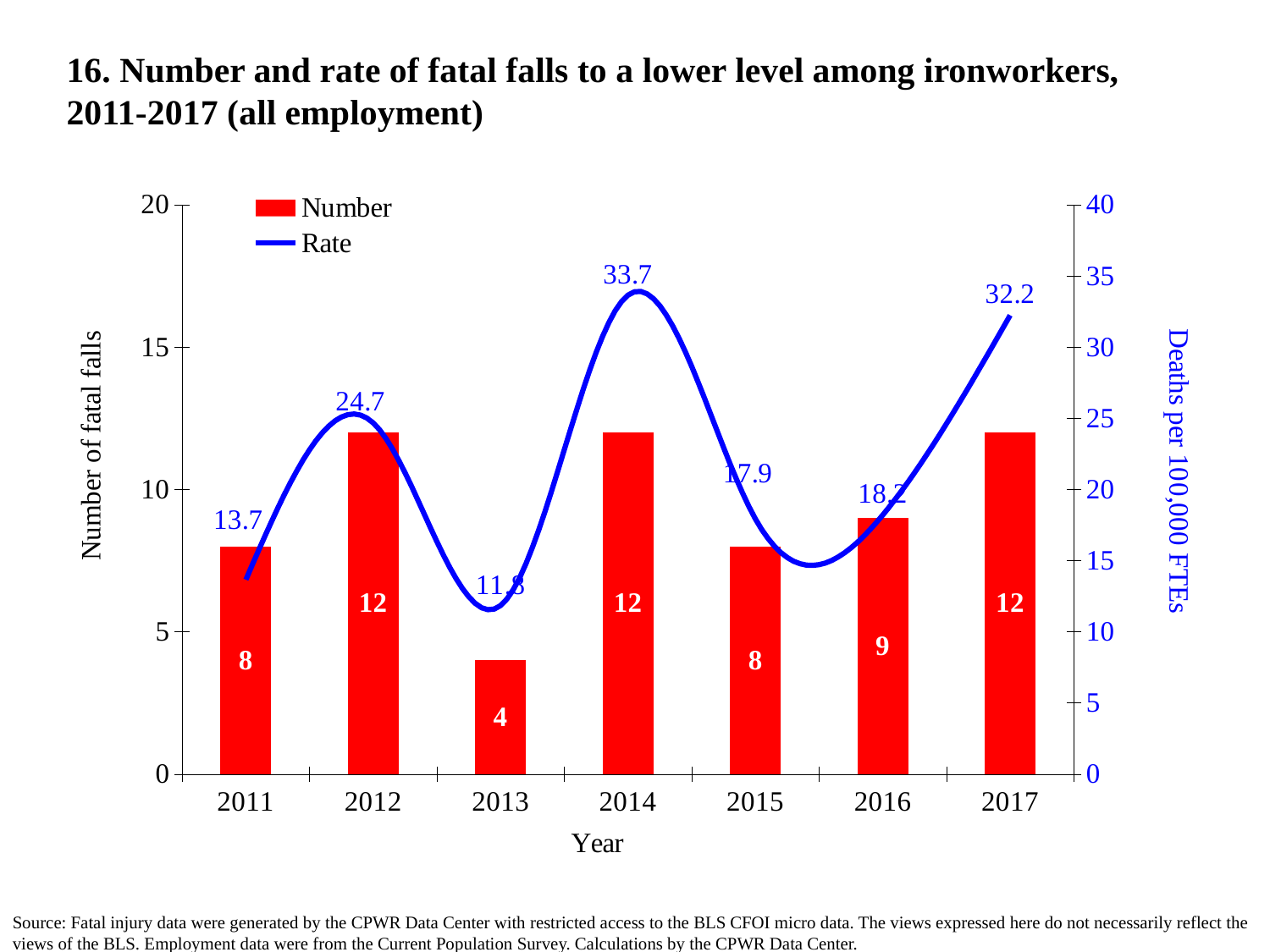
Which year has the higher rate of fatal falls, 2012 or 2017? 2017 How many years are shown on the x axis? 7 How many series does the legend list? 2 What is the difference between the rate in 2017 and the rate in 2011? 18.5 Does the rate rise or fall from 2015 to 2017? Rises What is the difference between the number of fatal falls in 2012 and in 2013? 8 What is the number of fatal falls in 2013? 4 What is the number of fatal falls in 2016? 9 What kind of chart is this? Combination bar and line chart Which year has the highest rate of fatal falls? 2014 What is the rate of fatal falls (deaths per 100,000 FTEs) in 2014? 33.7 Which year has the lowest number of fatal falls? 2013